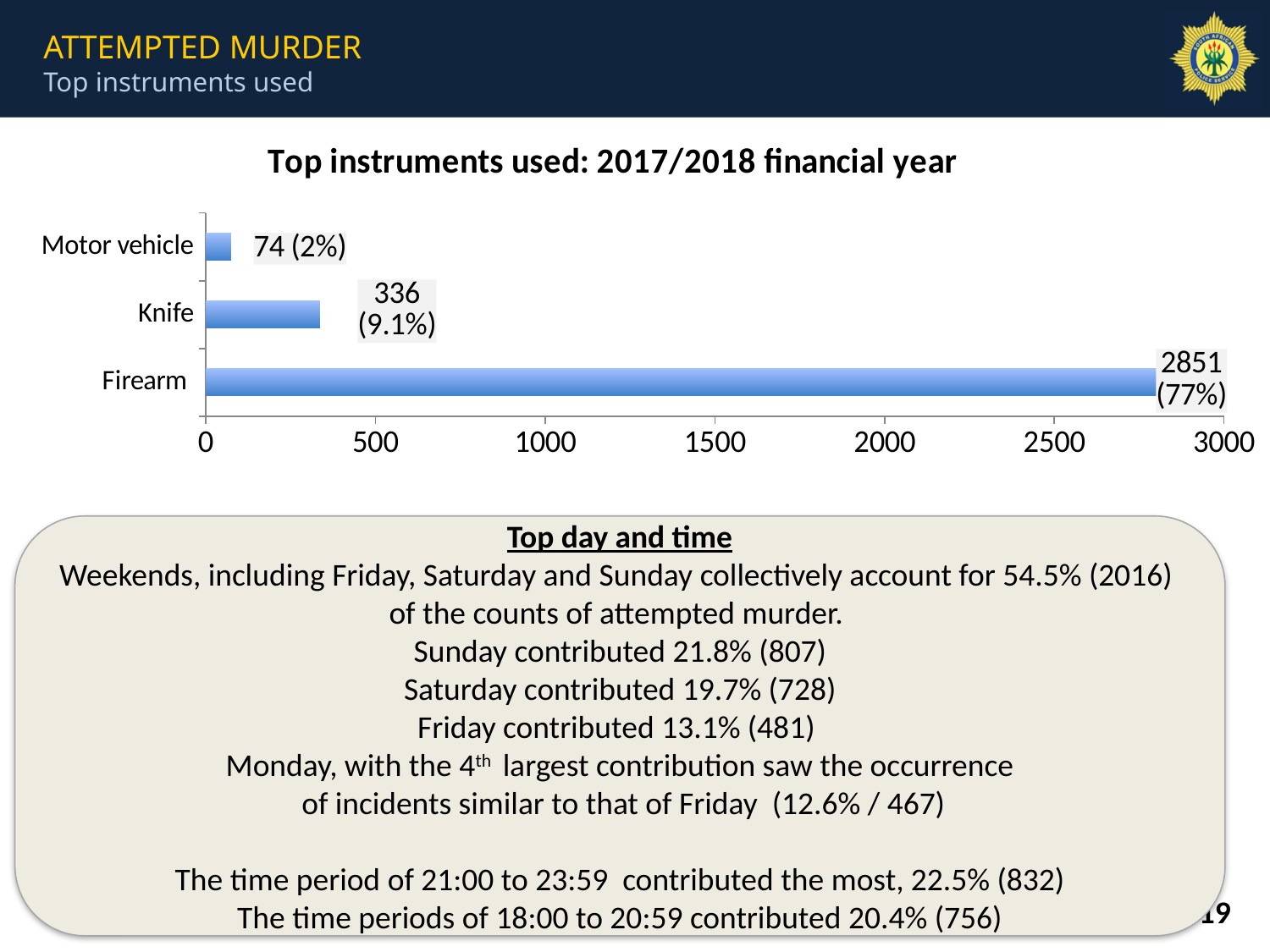
Which instrument has the lowest count? Motor vehicle What is the value for Firearm? 2851 (77%) How many instrument categories are shown in the chart? 3 What kind of chart is shown on the slide? Bar chart Which instrument has the highest count? Firearm What is the title of the chart? Top instruments used: 2017/2018 financial year Which is larger, the count for Knife or the count for Motor vehicle? Knife What is the value for Knife? 336 (9.1%) What is the value for Motor vehicle? 74 (2%) Is the value for Firearm greater or less than 2500? greater What is the difference between the counts for Knife and Motor vehicle? 262 What is the difference between the counts for Firearm and Knife? 2515